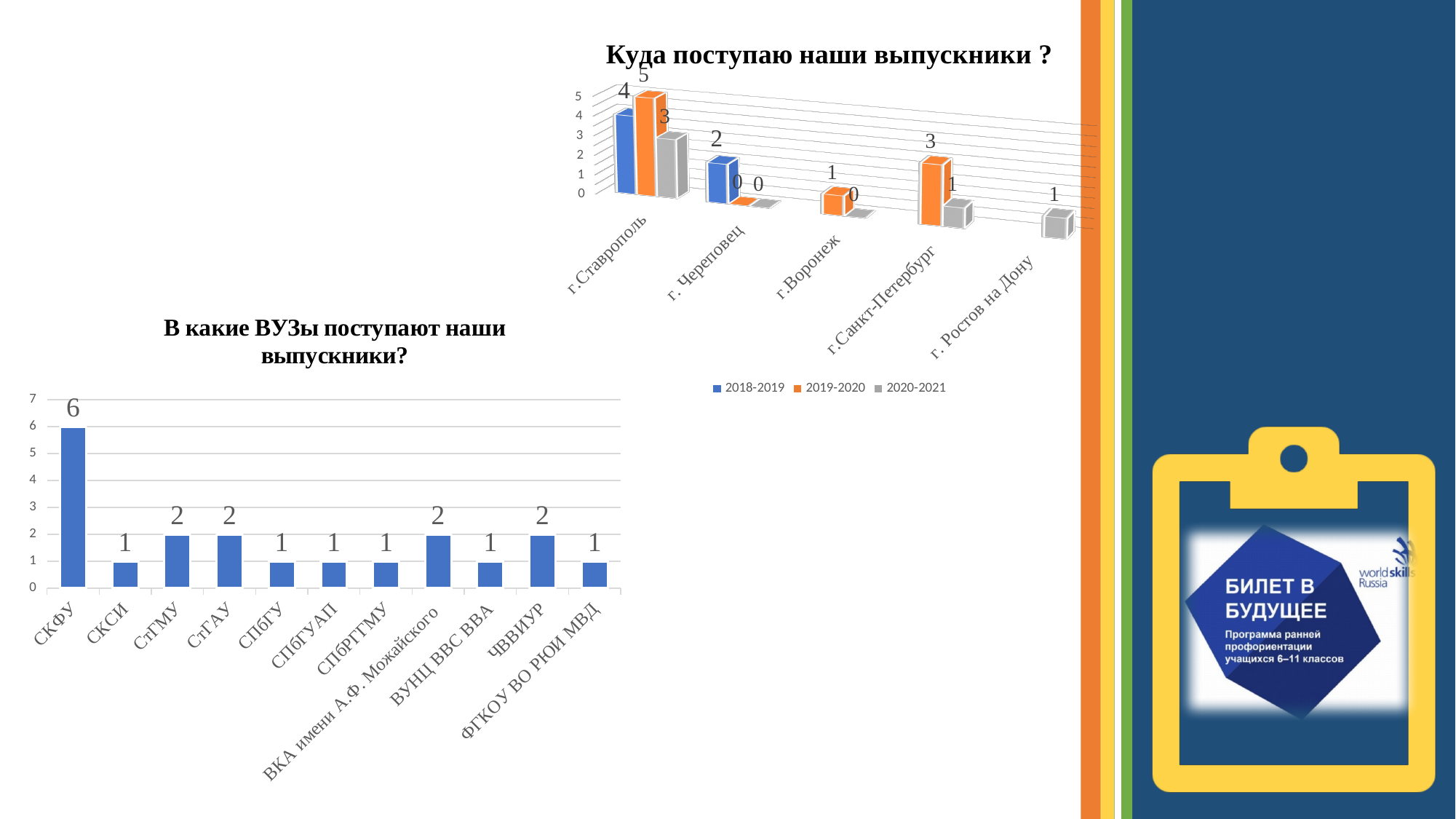
In the chart 'Куда поступаю наши выпускники ?', what is the value for г. Череповец in the 2018-2019 series? 2 In the chart 'Куда поступаю наши выпускники ?', what is the value for г.Ставрополь in the 2019-2020 series? 5 In the chart 'В какие ВУЗы поступают наши выпускники?', what is the value for ВКА имени А.Ф. Можайского? 2 In the chart 'В какие ВУЗы поступают наши выпускники?', what is the value for СКФУ? 6 In the chart 'В какие ВУЗы поступают наши выпускники?', how many universities are shown on the x axis? 11 In the chart 'В какие ВУЗы поступают наши выпускники?', which university has the highest value? СКФУ In the chart 'В какие ВУЗы поступают наши выпускники?', which is larger: the value for ЧВВИУР or the value for СПбГУ? ЧВВИУР In the chart 'Куда поступаю наши выпускники ?', how many series does the legend list? 3 In the chart 'В какие ВУЗы поступают наши выпускники?', what is the difference between the values for СКФУ and СтГМУ? 4 What kind of chart is 'В какие ВУЗы поступают наши выпускники?'? Bar chart In the chart 'Куда поступаю наши выпускники ?', what is the value for г.Санкт-Петербург in the 2019-2020 series? 3 In the chart 'Куда поступаю наши выпускники ?', what is the difference between the 2019-2020 and 2020-2021 values for г.Ставрополь? 2